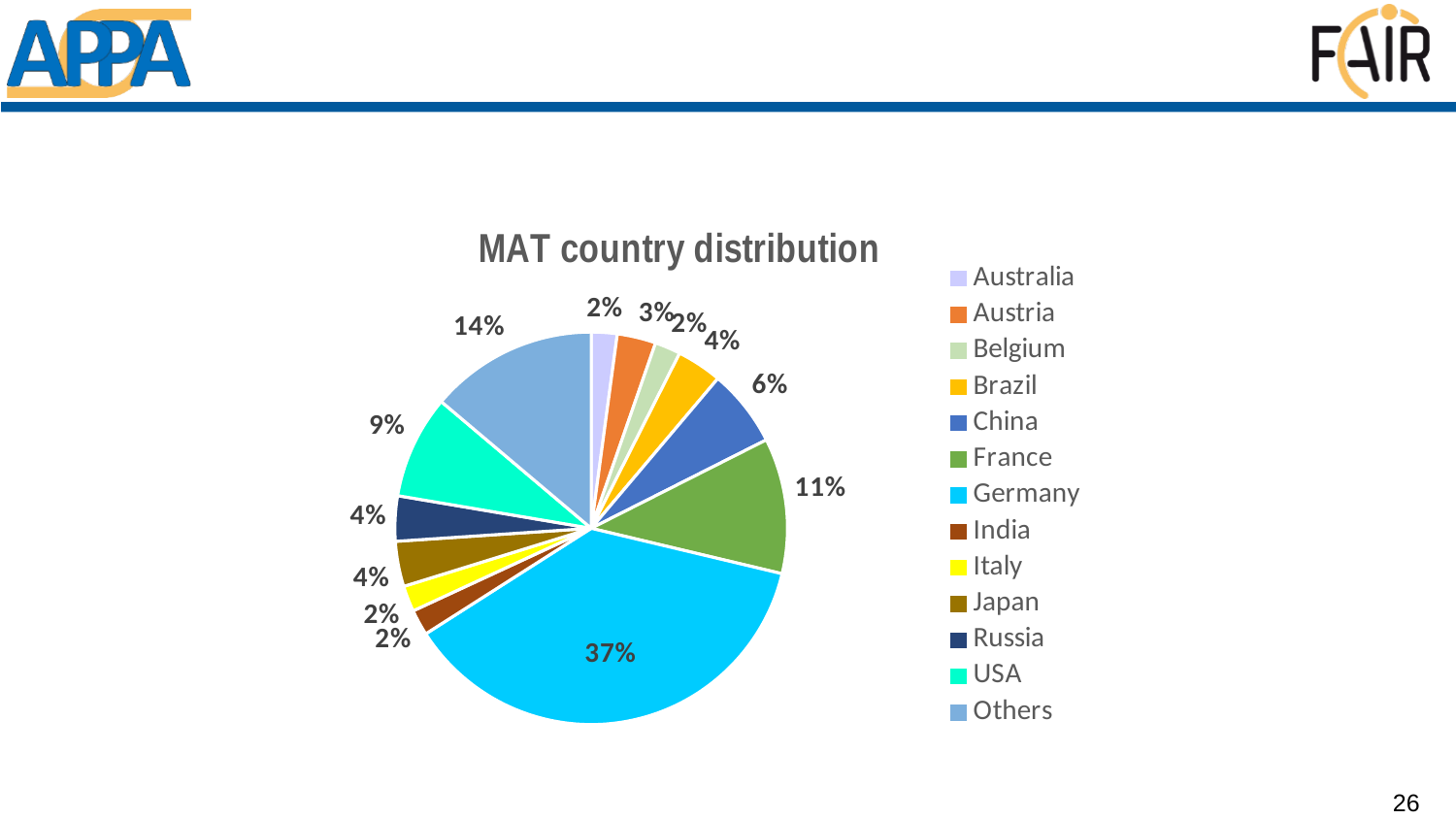
What is the title of the chart? MAT country distribution What share of the pie does Germany have? 37% What share of the pie does USA have? 9% What is the difference between the share for Germany and the share for Others? 23% Which is larger, the share for France or the share for USA? France What share of the pie does France have? 11% What type of chart is shown on the slide? pie chart Which country has the largest share of the pie? Germany How many categories does the legend list? 13